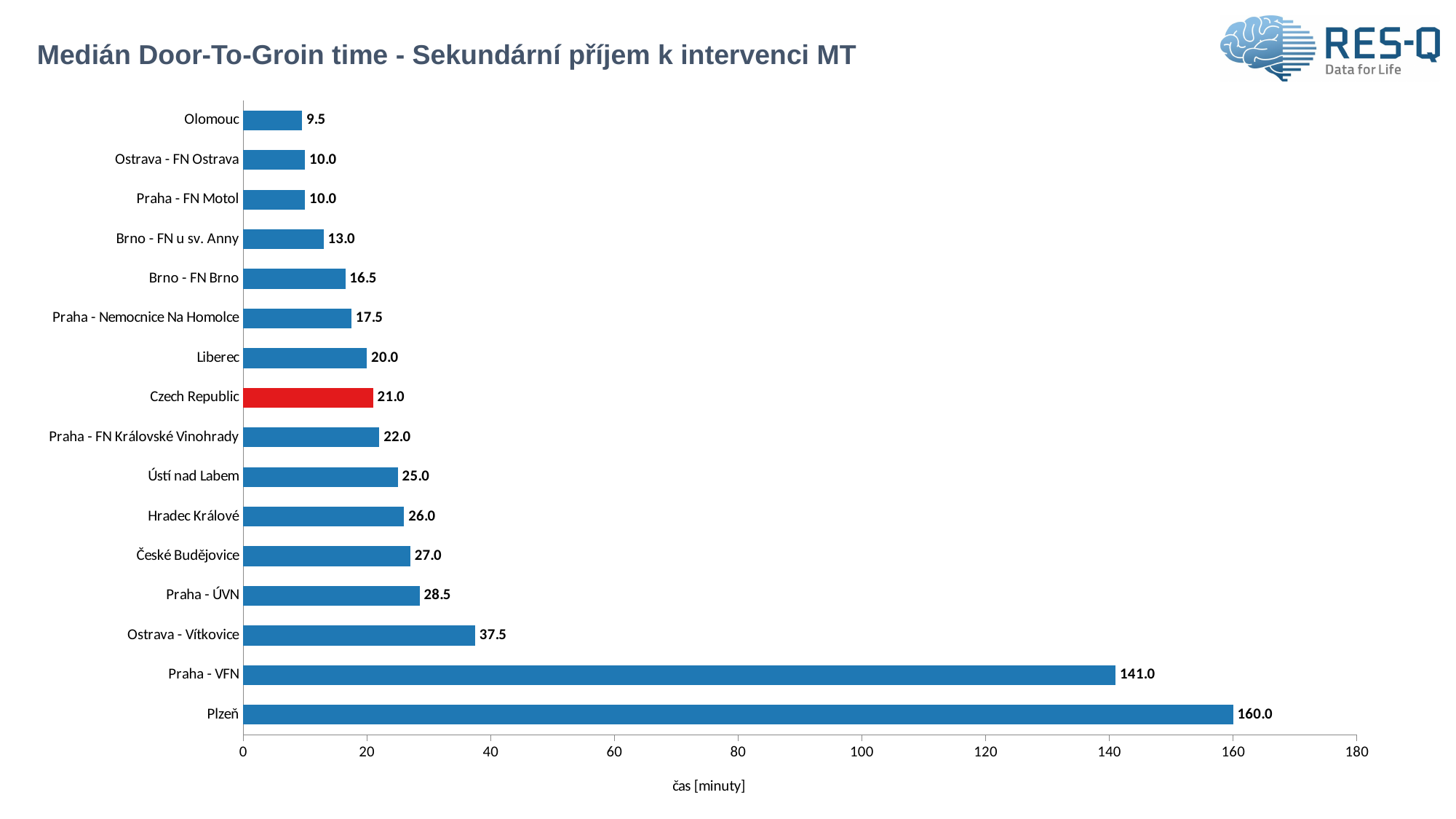
What is the label of the horizontal axis? čas [minuty] What is the difference between the values for Plzeň and Praha - VFN? 19.0 Which category has the highest median Door-To-Groin time? Plzeň What is the value shown for Ostrava - Vítkovice? 37.5 Which category has the lowest median Door-To-Groin time? Olomouc Is the value for Praha - VFN greater or less than 120? greater What is the value shown for Czech Republic? 21.0 Which is larger, the value for Liberec or the value for Hradec Králové? Hradec Králové Which category's bar is coloured red? Czech Republic How many categories are shown on the chart? 16 What kind of chart is shown on the slide? bar chart What is the median Door-To-Groin time for Plzeň? 160.0